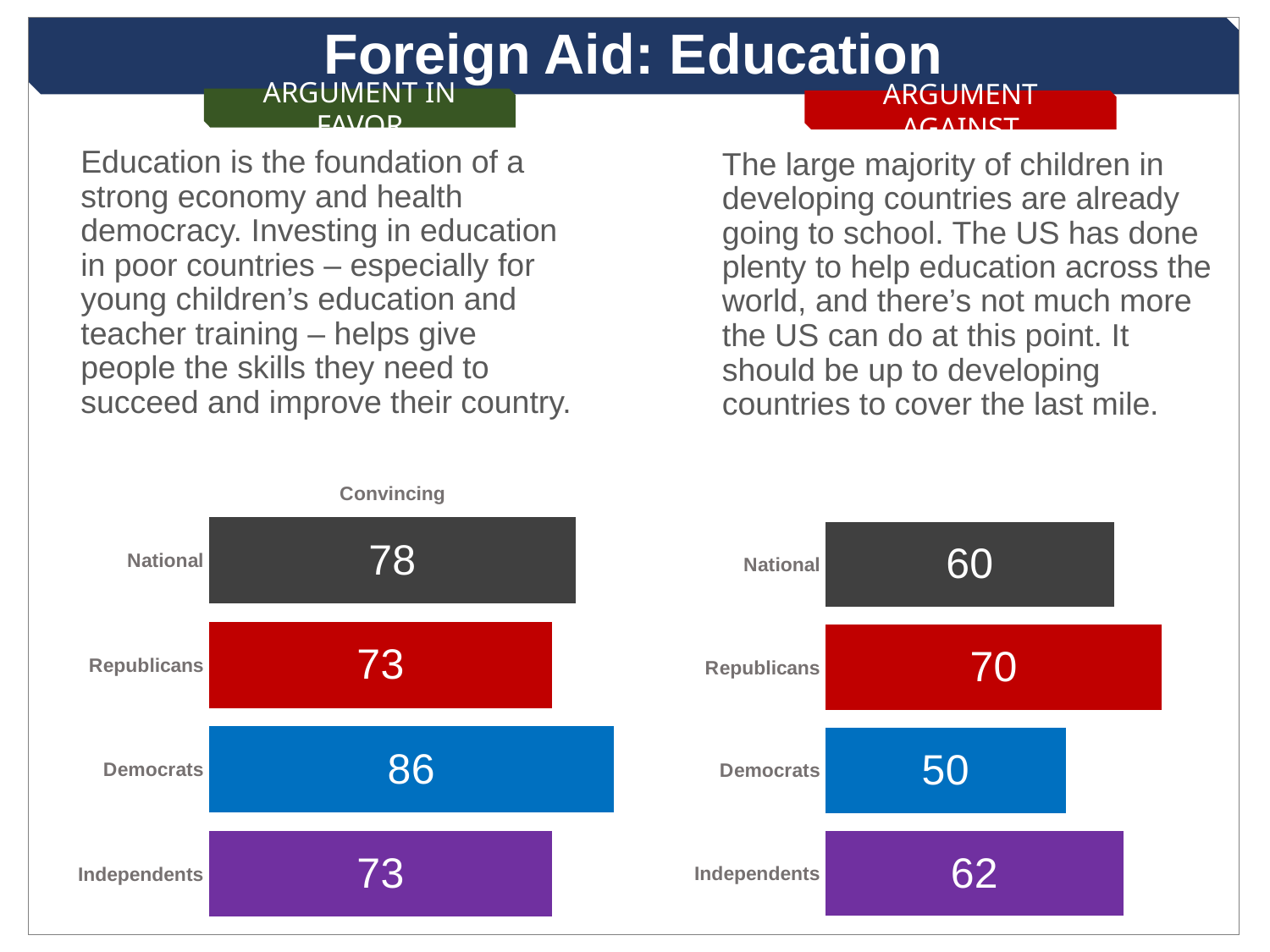
In the left chart (Argument in Favor), what is the value for National? 78 In the right chart (Argument Against), which group has the lowest value? Democrats Which is larger: the National value in the left chart (Argument in Favor) or the National value in the right chart (Argument Against)? Argument in Favor In the right chart (Argument Against), which group has the highest value? Republicans What type of chart is used on the slide? Bar chart In the right chart (Argument Against), what is the value for Independents? 62 In the left chart (Argument in Favor), which group has the highest value? Democrats In the right chart (Argument Against), what is the difference between the National value and the Democrats value? 10 In the left chart (Argument in Favor), what is the difference between the Democrats value and the Republicans value? 13 How many groups are shown in the left chart (Argument in Favor)? 4 In the right chart (Argument Against), what is the value for Republicans? 70 In the left chart (Argument in Favor), what is the value for Democrats? 86